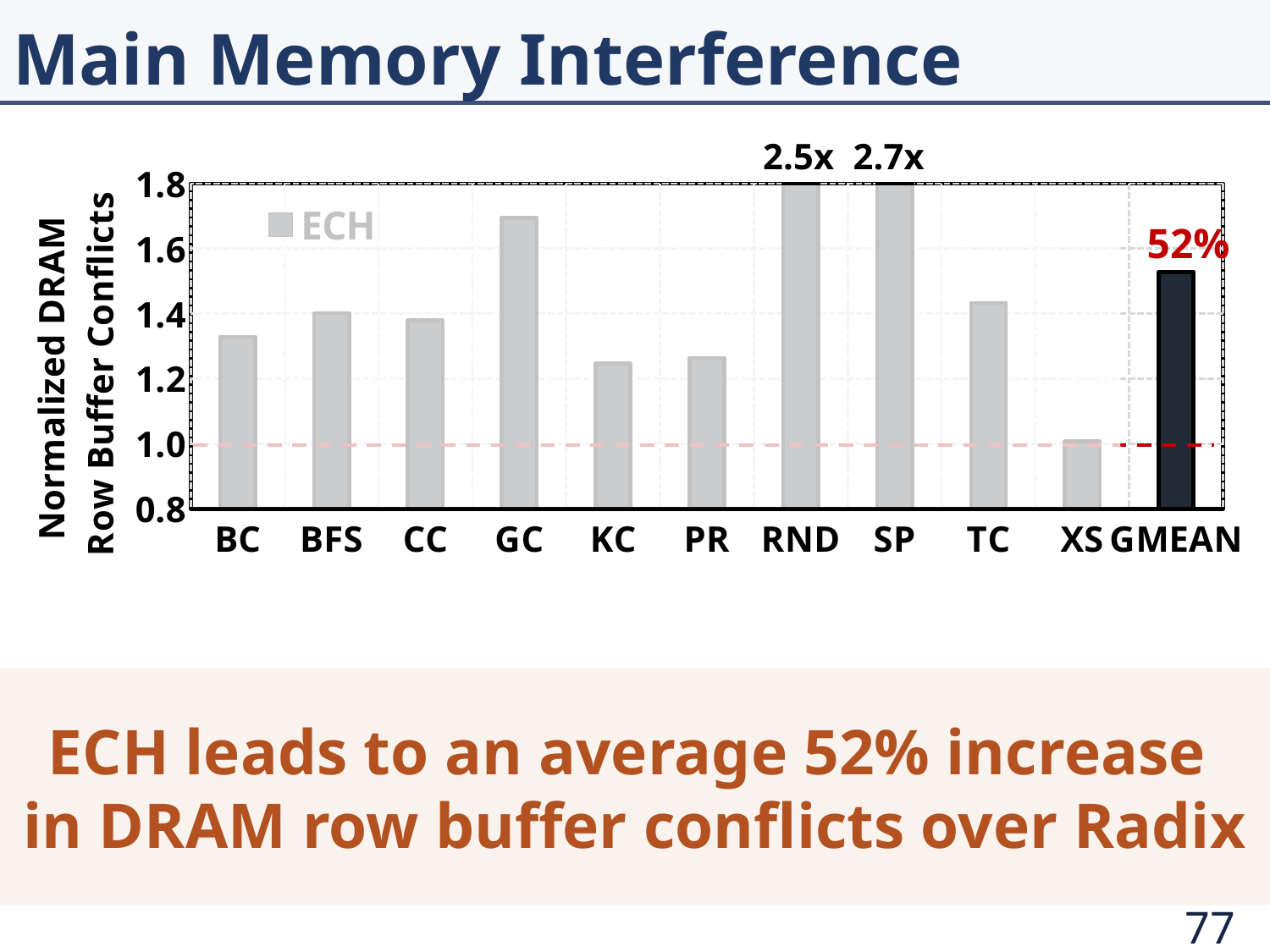
What kind of chart is shown on the slide? bar chart Which category has the highest normalized DRAM row buffer conflicts? SP Is the value for XS greater or less than 1.2? less How many categories are shown along the x axis of the chart? 11 Which has a larger value, GC or BC? GC What value is labelled above the RND bar? 2.5x How many series does the chart's legend list? 1 Is the value for GC greater or less than 1.6? greater What series name is shown in the chart's legend? ECH What value is labelled above the GMEAN bar? 52% Which category has the lowest normalized DRAM row buffer conflicts? XS What value is labelled above the SP bar? 2.7x